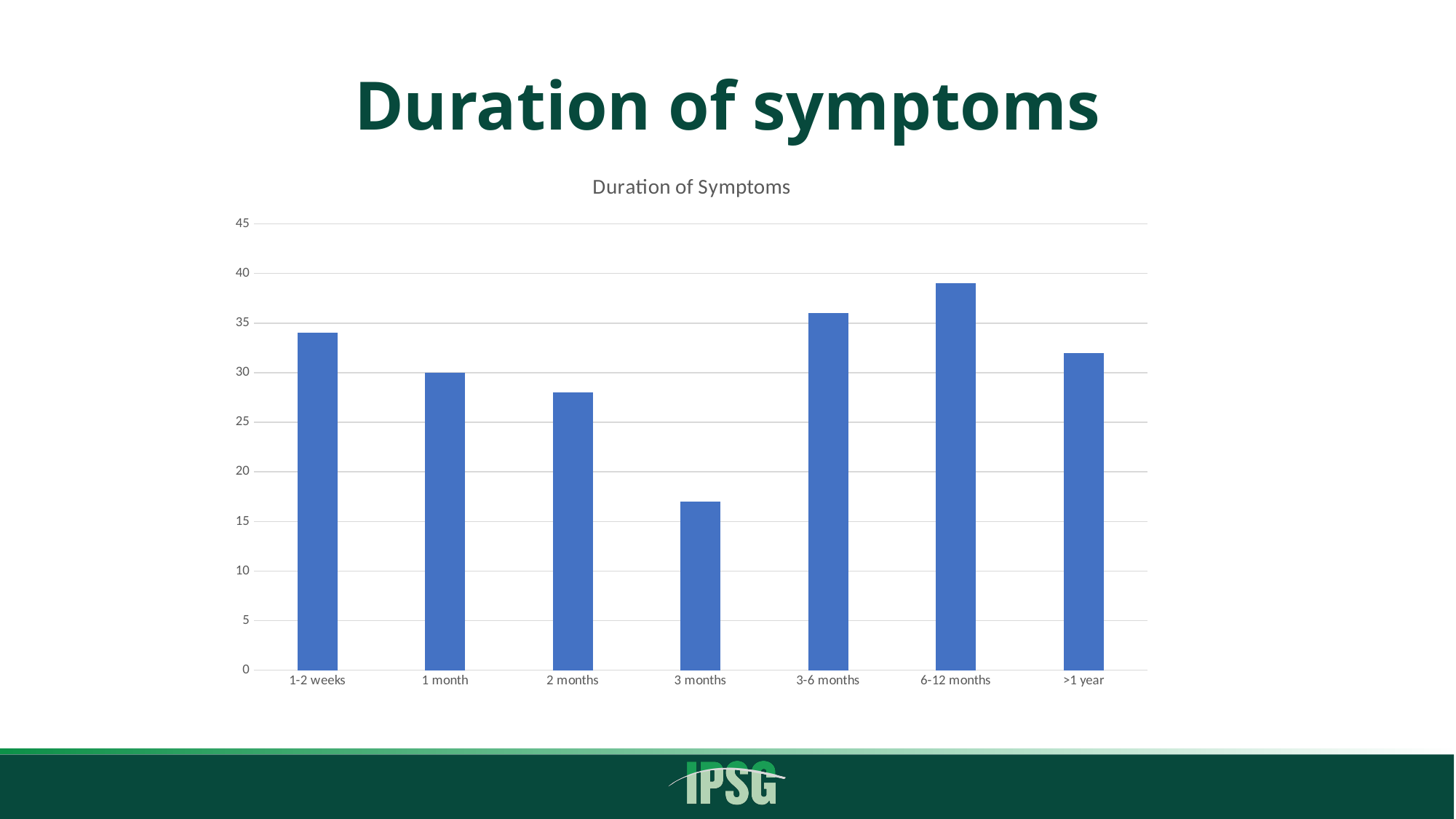
What is the value for 1 month? 30 How many categories are shown on the x axis of the chart? 7 Is the value for 6-12 months greater or less than 35? greater Which is larger, the value for 2 months or the value for 3 months? 2 months Which category has the highest value? 6-12 months Which category has the lowest value? 3 months Is the value for 3 months greater or less than 20? less What type of chart is shown on the slide? bar chart Which is larger, the value for 3-6 months or the value for 1 month? 3-6 months Do the values rise or fall from 1-2 weeks to 3 months? fall Is the value for 2 months greater or less than 25? greater What is the title of the chart? Duration of Symptoms